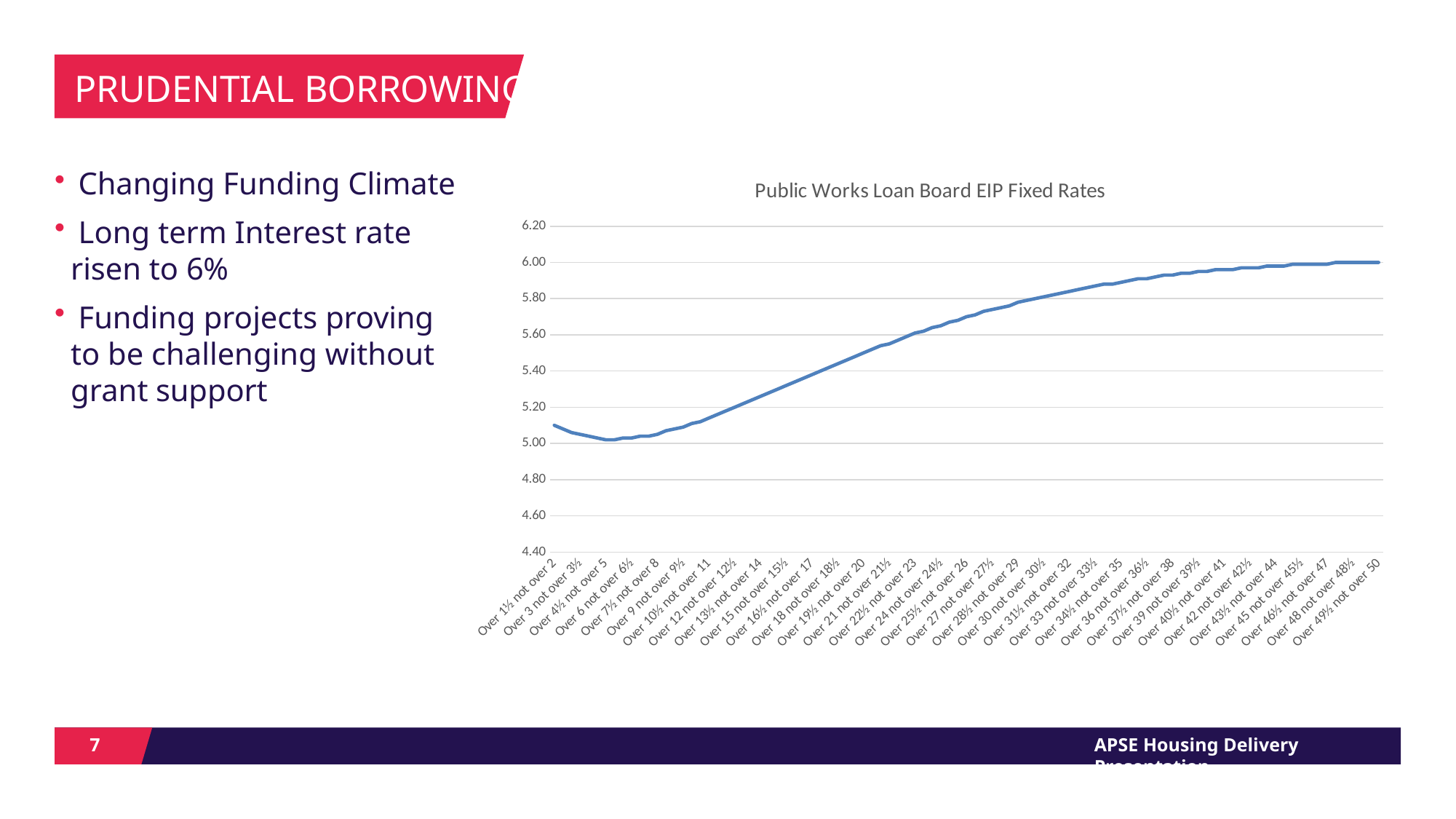
Is the value for "Over 36 not over 36½" greater or less than 6.00? less Is the value for "Over 49½ not over 50" greater or less than 5.80? greater What is the highest value shown on the vertical axis? 6.20 Is the value for "Over 27 not over 27½" greater or less than 5.60? greater What kind of chart is shown on the slide? Line chart What is the title of the chart? Public Works Loan Board EIP Fixed Rates Do the fixed rates generally rise or fall as the loan period increases along the x axis? Rise Which has the larger value, "Over 1½ not over 2" or "Over 49½ not over 50"? Over 49½ not over 50